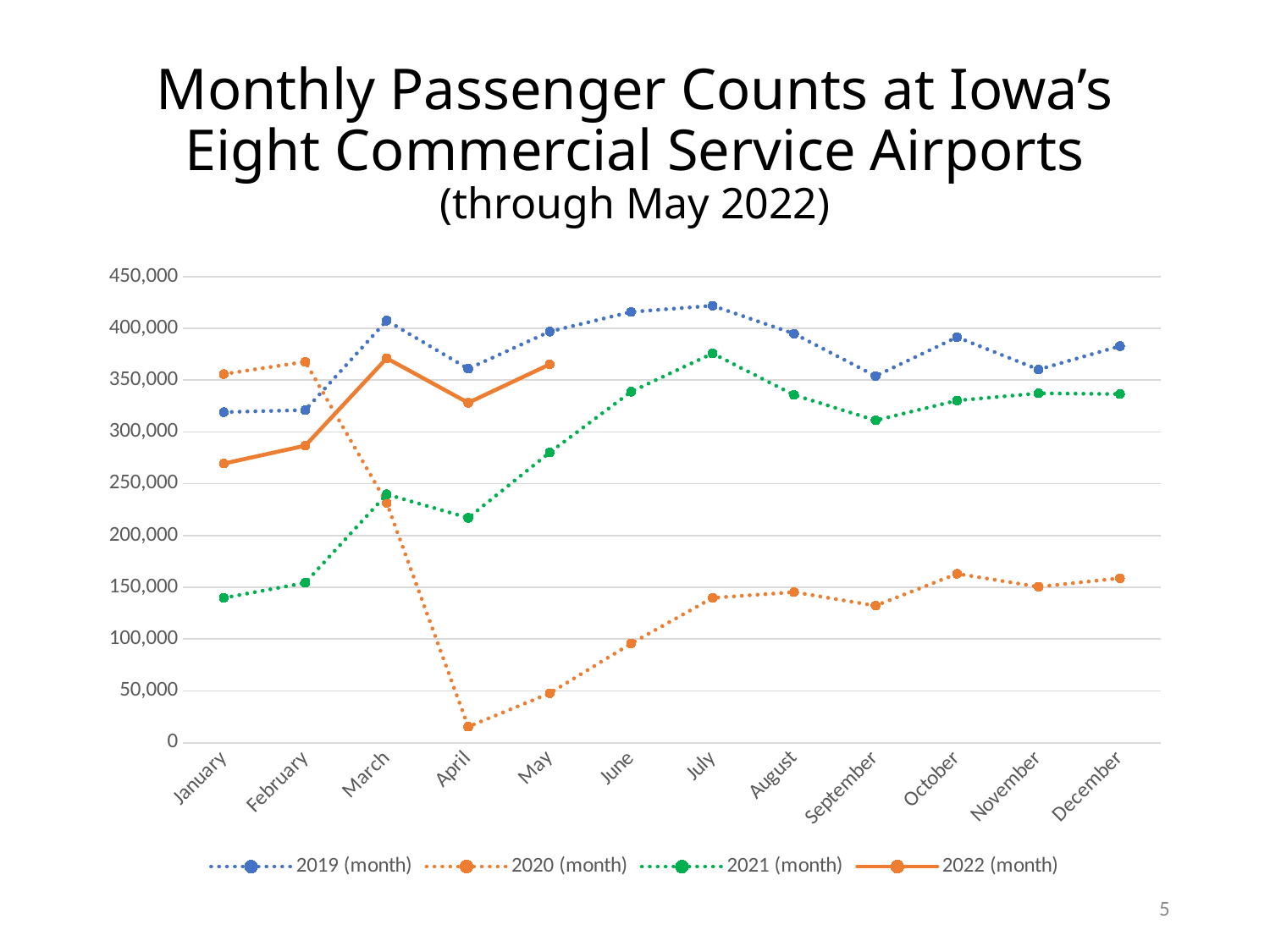
Is the 2022 (month) value for March greater or less than 350,000? greater What kind of chart is shown on the slide? line chart Is the 2019 (month) value for July greater or less than 400,000? greater What is the title of the chart? Monthly Passenger Counts at Iowa's Eight Commercial Service Airports (through May 2022) Which month has the lowest value for the 2020 (month) series? April Is the 2020 (month) value for April greater or less than 50,000? less Which month has the highest value for the 2021 (month) series? July How many months are shown along the x axis? 12 In March, which series has the higher value, 2019 (month) or 2020 (month)? 2019 (month) How many series does the legend list? 4 Does the 2021 (month) series rise or fall from January to July? rise